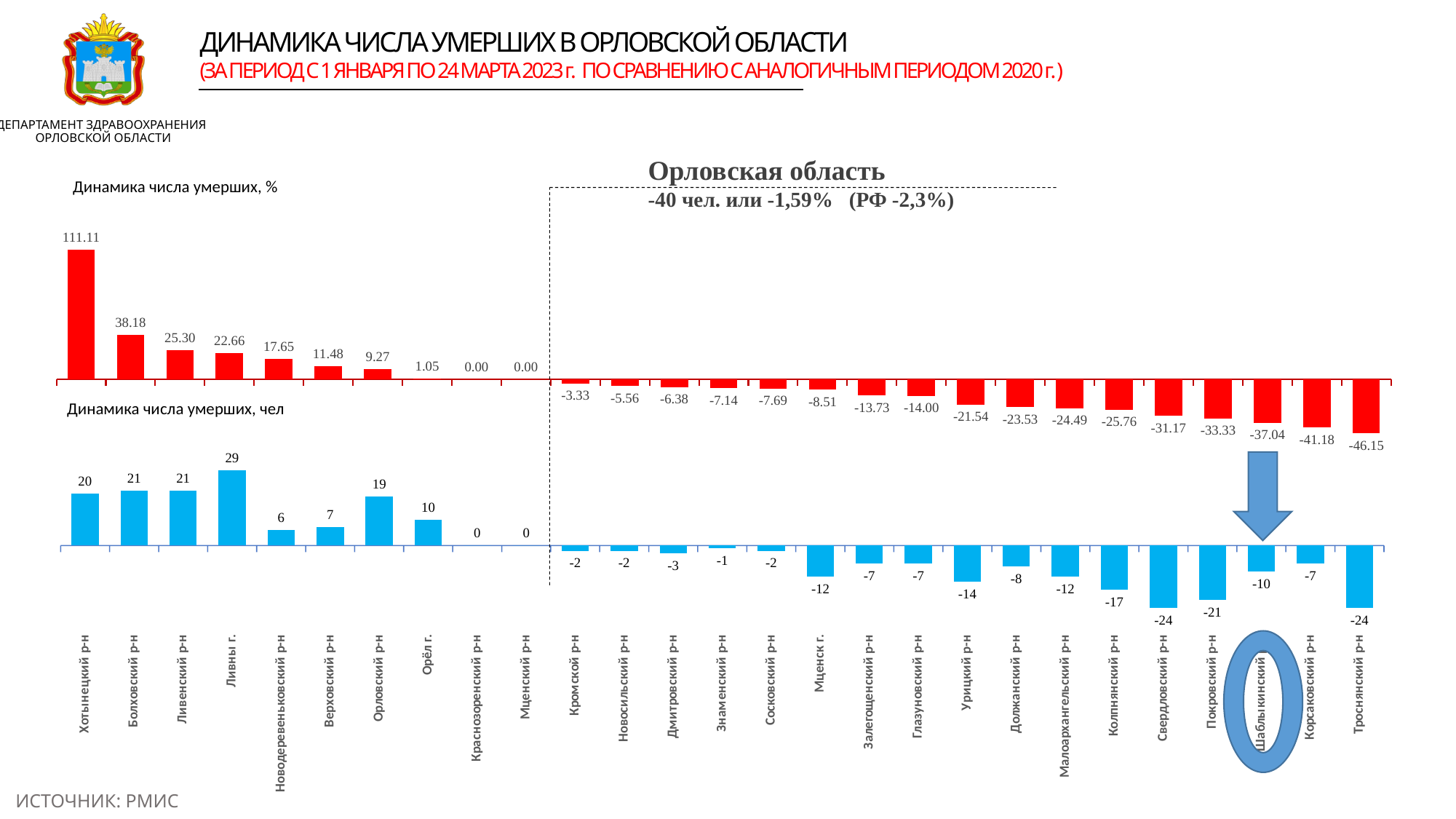
In the top chart 'Динамика числа умерших, %', what is the value for Хотынецкий р-н? 111.11 In the bottom chart 'Динамика числа умерших, чел', what is the value for Ливны г.? 29 In the bottom chart 'Динамика числа умерших, чел', which category has the highest value? Ливны г. In the top chart 'Динамика числа умерших, %', which category has the lowest value? Троснянский р-н In the top chart 'Динамика числа умерших, %', which is larger, the value for Болховский р-н or the value for Ливенский р-н? Болховский р-н What kind of chart is the top chart 'Динамика числа умерших, %'? bar chart How many categories are shown on the x axis of the bottom chart 'Динамика числа умерших, чел'? 27 In the bottom chart 'Динамика числа умерших, чел', what is the value for Свердловский р-н? -24 In the top chart 'Динамика числа умерших, %', which category has the highest value? Хотынецкий р-н In the bottom chart 'Динамика числа умерших, чел', what is the difference between the values for Ливны г. and Орловский р-н? 10 In the bottom chart 'Динамика числа умерших, чел', what is the value for Шаблыкинский р-н? -10 In the top chart 'Динамика числа умерших, %', what is the value for Троснянский р-н? -46.15